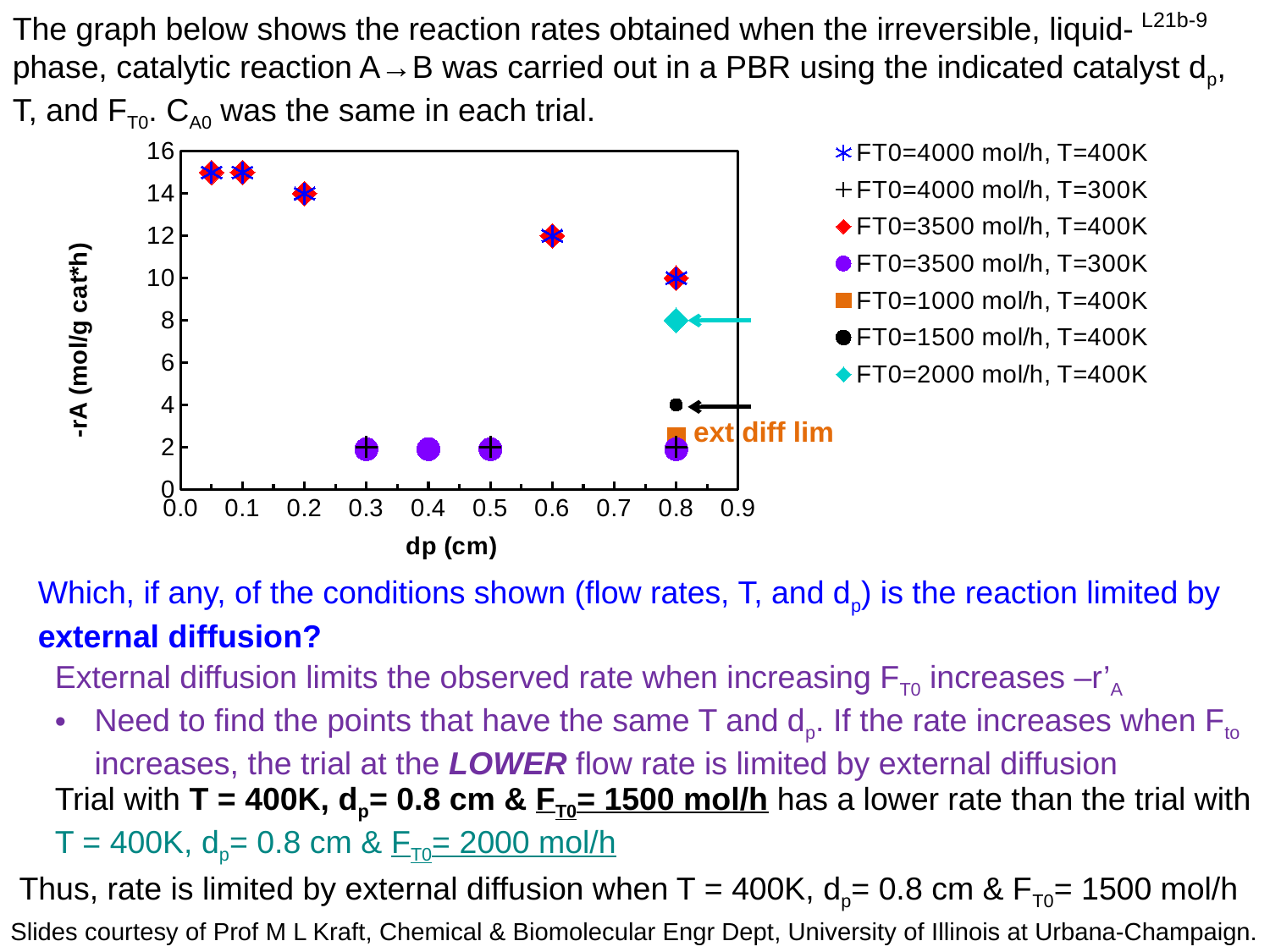
What is the y-axis title of the chart? -rA (mol/g cat*h) What kind of chart is shown on the slide? scatter chart Is the value for the FT0=1000 mol/h, T=400K series at dp = 0.8 cm greater or less than 4? less What is the reaction rate -rA for the FT0=4000 mol/h, T=400K series at dp = 0.6 cm? 12 At dp = 0.8 cm, what is the difference in -rA between the FT0=2000 mol/h, T=400K point and the FT0=1500 mol/h, T=400K point? 4 At dp = 0.8 cm, which series has the larger rate: FT0=2000 mol/h, T=400K or FT0=1500 mol/h, T=400K? FT0=2000 mol/h, T=400K What is the reaction rate -rA for the FT0=2000 mol/h, T=400K series at dp = 0.8 cm? 8 What is the reaction rate -rA for the FT0=1500 mol/h, T=400K series at dp = 0.8 cm? 4 What is the x-axis title of the chart? dp (cm) Is the value for the FT0=3500 mol/h, T=300K series at dp = 0.4 cm greater or less than 4? less For the FT0=4000 mol/h, T=400K series, does the reaction rate rise or fall as dp increases? fall How many series does the chart legend list? 7